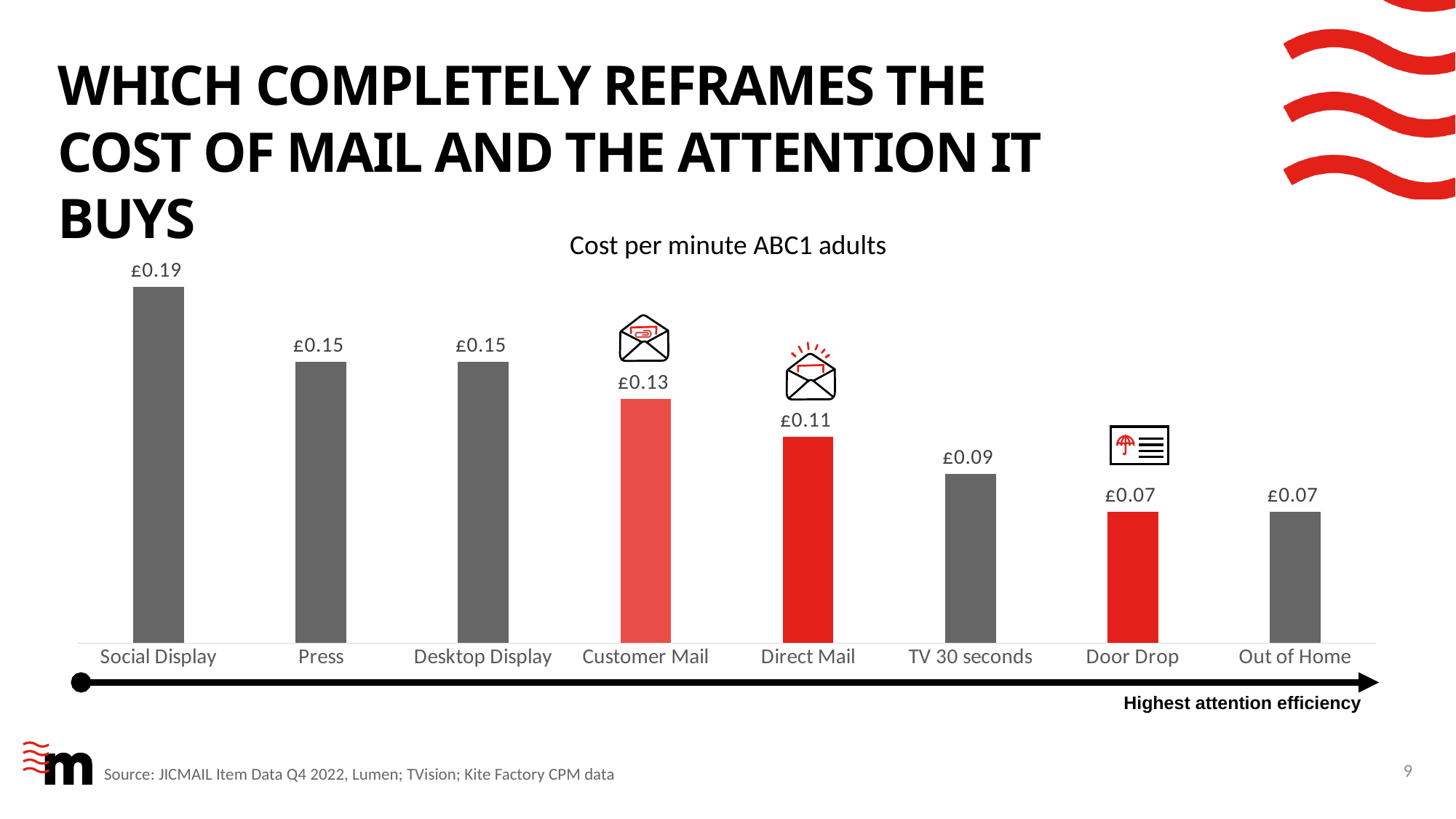
What is the difference in cost per minute between Social Display and Door Drop? £0.12 Do the values generally rise or fall from left to right along the x axis? Fall What kind of chart is shown on the slide? Bar chart What is the title of the chart? Cost per minute ABC1 adults What is the cost per minute for TV 30 seconds? £0.09 What is the cost per minute for Customer Mail? £0.13 Which has a higher cost per minute, Press or TV 30 seconds? Press What is the difference in cost per minute between Customer Mail and Direct Mail? £0.02 What is the cost per minute for Direct Mail? £0.11 What is the cost per minute for Social Display? £0.19 Which category has the highest cost per minute? Social Display How many categories are shown in the chart? 8